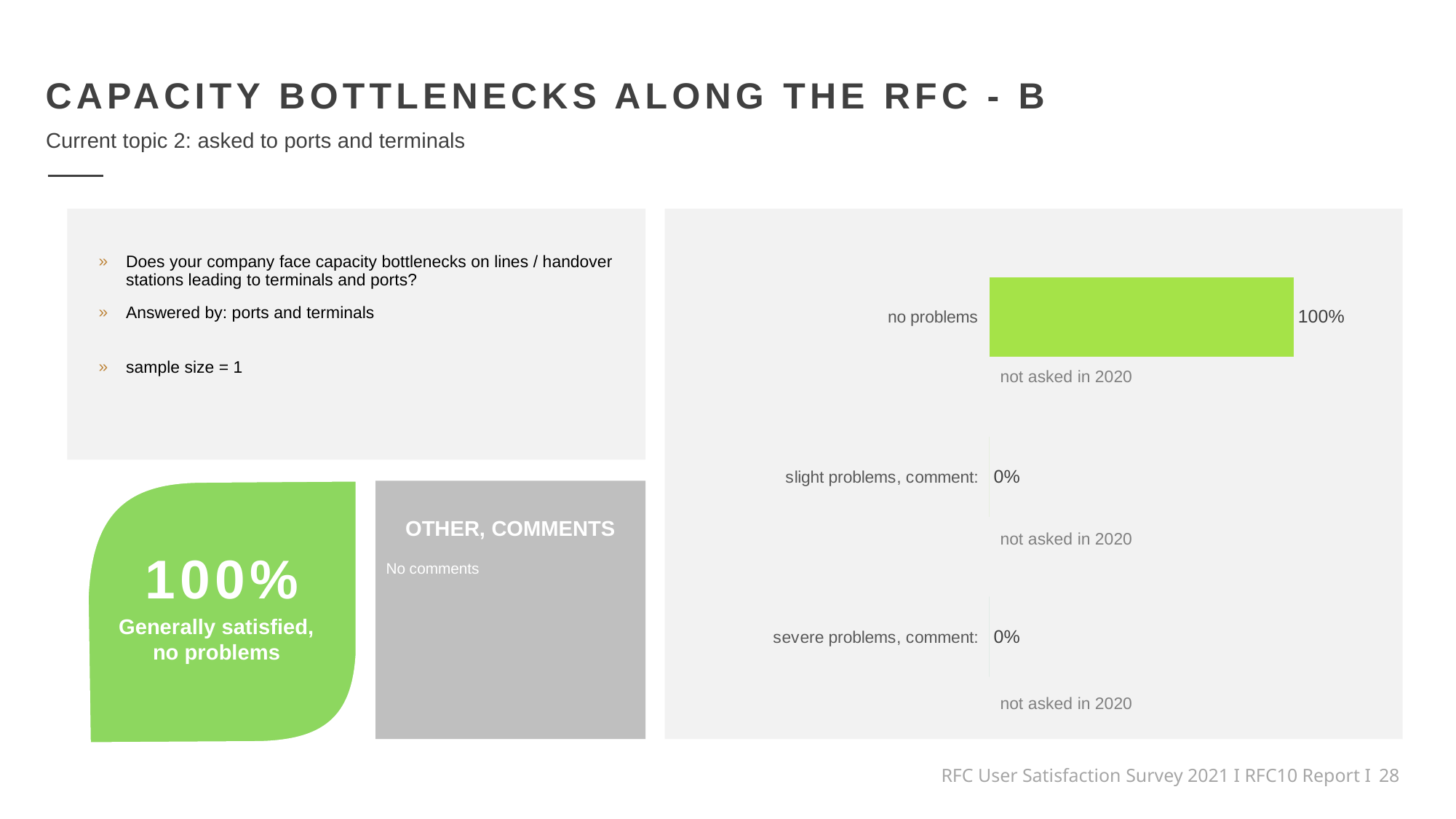
What text appears below each category in the chart regarding the 2020 survey? not asked in 2020 How many categories are shown in the chart? 3 Which category has the highest value in the chart? no problems What colour is the bar for "no problems"? green What is the value for "no problems" in the chart? 100% What kind of chart is shown on the slide? bar chart What is the value for "slight problems, comment:" in the chart? 0% What is the total of the three category values shown in the chart? 100% What is the value for "severe problems, comment:" in the chart? 0% What is the difference between the values for "no problems" and "slight problems, comment:"? 100% Which is larger: the value for "no problems" or the value for "severe problems, comment:"? no problems